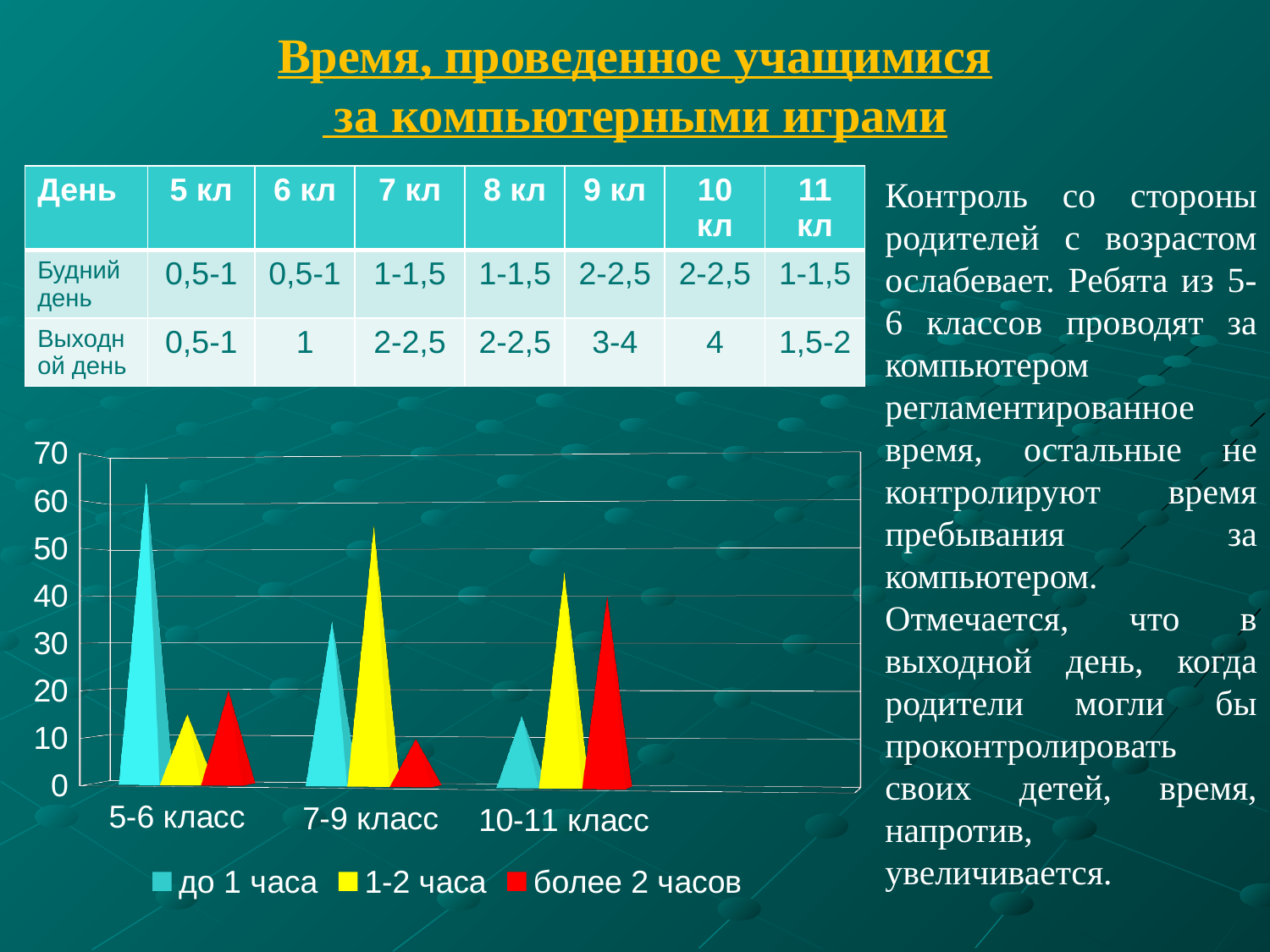
Which is larger: the value for до 1 часа in the 5-6 класс group or in the 7-9 класс group? 5-6 класс How many class groups (categories) are shown on the x axis of the chart? 3 Is the value for до 1 часа in the 5-6 класс group greater or less than 50? greater What kind of chart is shown on the slide? bar chart Does the value for до 1 часа rise or fall from 5-6 класс to 10-11 класс? fall For the 7-9 класс group, which series has the lowest value? более 2 часов Is the value for более 2 часов in the 10-11 класс group greater or less than 30? greater Is the value for более 2 часов in the 7-9 класс group greater or less than 20? less For the 7-9 класс group, which series has the highest value? 1-2 часа For the 5-6 класс group, which series has the highest value? до 1 часа How many series does the chart legend list? 3 What colour represents the series более 2 часов in the chart? red